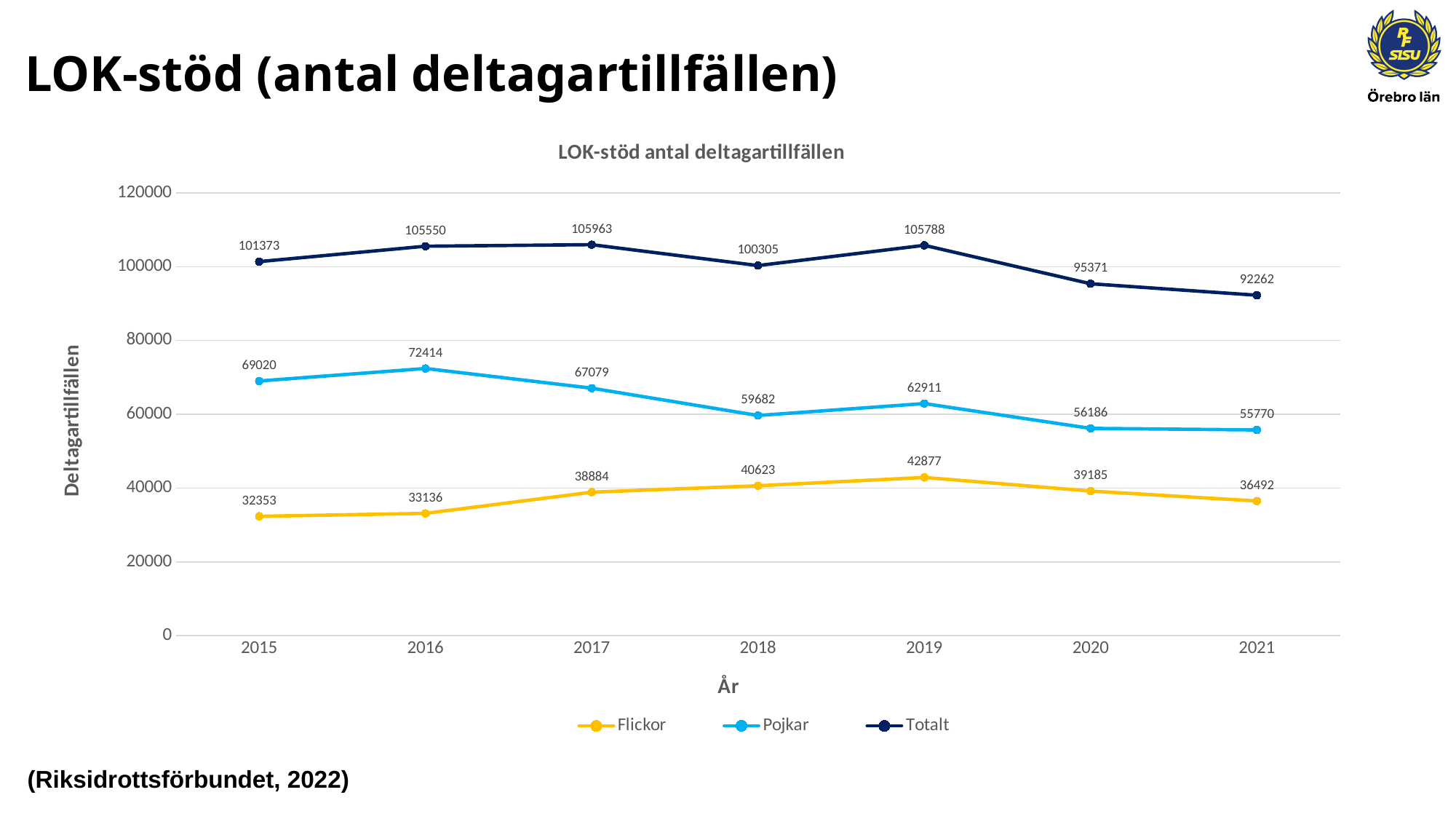
In which year is the Flickor series highest? 2019 Does the Totalt series rise or fall from 2019 to 2021? fall How many years are shown on the x axis? 7 What is the Pojkar value for 2018? 59682 Which is larger, the Pojkar value in 2016 or the Pojkar value in 2019? 2016 What is the Flickor value for 2019? 42877 What kind of chart is shown on the slide? line chart What is the difference between the Pojkar and Flickor values in 2016? 39278 How many series does the legend list? 3 By how much did the Totalt value fall from 2015 to 2021? 9111 In which year is the Pojkar series lowest? 2021 What is the Totalt value for 2017? 105963